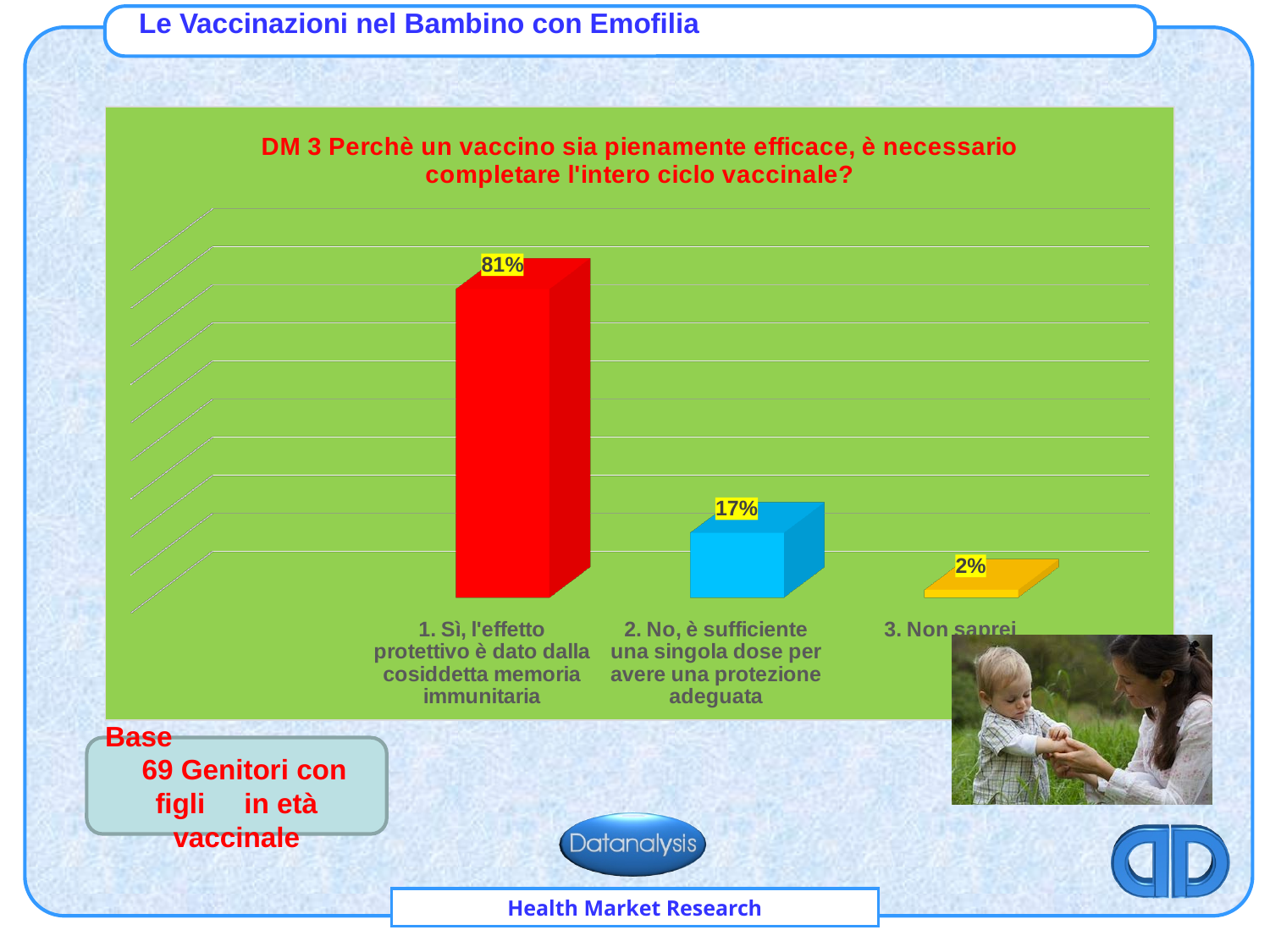
How many answer categories are shown in the chart? 3 What colour is the bar for "1. Sì, l'effetto protettivo è dato dalla cosiddetta memoria immunitaria"? Red What is the difference in percentage points between the "No" answer and "Non saprei"? 15 Which answer option has the highest percentage? 1. Sì, l'effetto protettivo è dato dalla cosiddetta memoria immunitaria What percentage of respondents answered "1. Sì, l'effetto protettivo è dato dalla cosiddetta memoria immunitaria"? 81% What type of chart is shown on the slide? Bar chart What percentage of respondents answered "3. Non saprei"? 2% Which is larger: the percentage for "2. No, è sufficiente una singola dose" or for "3. Non saprei"? 2. No, è sufficiente una singola dose What is the title of the chart? DM 3 Perchè un vaccino sia pienamente efficace, è necessario completare l'intero ciclo vaccinale? Which answer option has the lowest percentage? 3. Non saprei What is the difference in percentage points between the "Sì" answer and the "No" answer? 64 What percentage of respondents answered "2. No, è sufficiente una singola dose per avere una protezione adeguata"? 17%